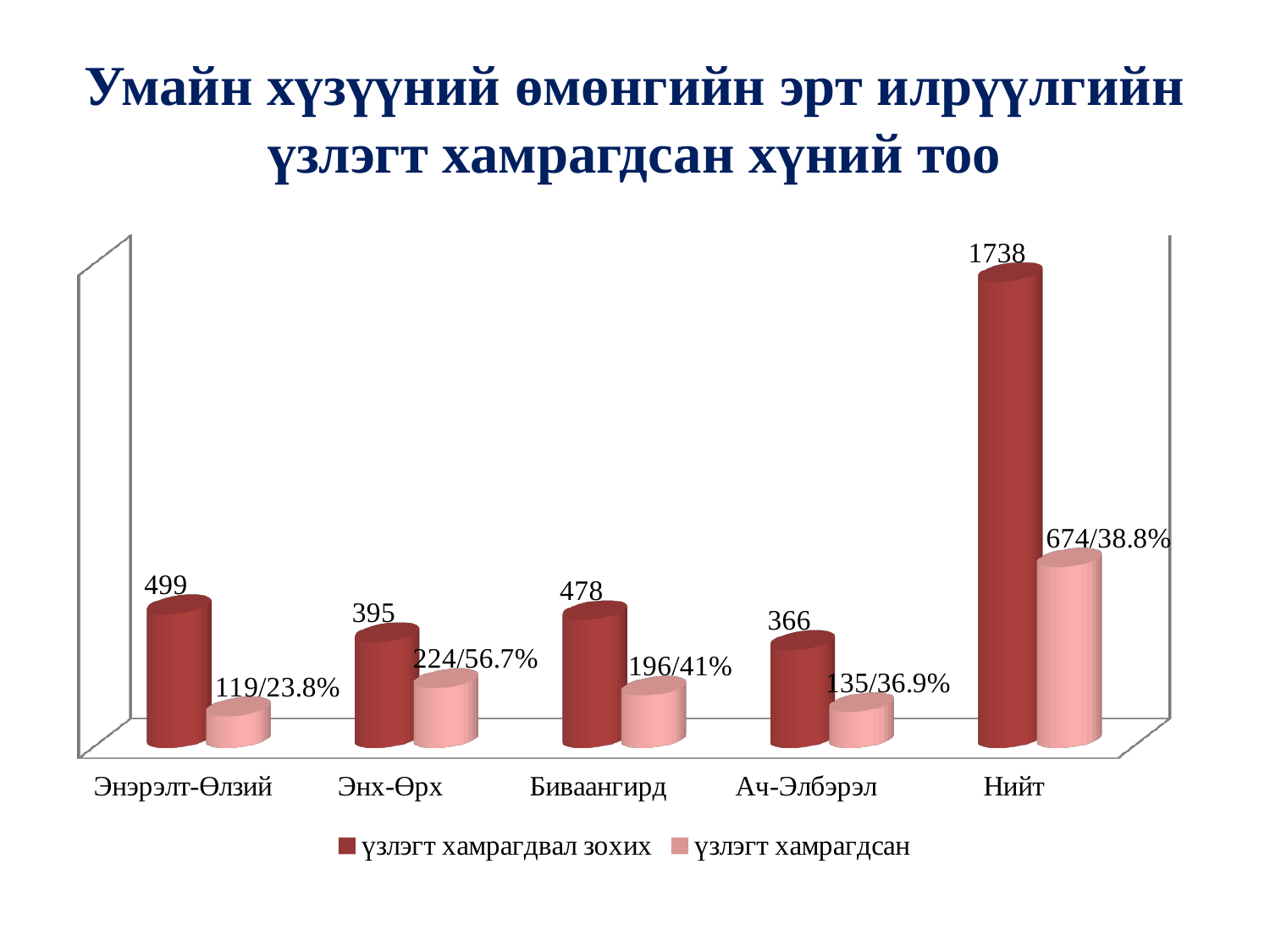
What is the value of "үзлэгт хамрагдвал зохих" for Энэрэлт-Өлзий? 499 What is the difference between the "үзлэгт хамрагдвал зохих" values for Энэрэлт-Өлзий and Энх-Өрх? 104 What data label is shown for "үзлэгт хамрагдсан" for Ач-Элбэрэл? 135/36.9% Which category has the lowest value for "үзлэгт хамрагдвал зохих"? Ач-Элбэрэл What data label is shown for "үзлэгт хамрагдсан" for Энх-Өрх? 224/56.7% Excluding Нийт, which category has the highest value for "үзлэгт хамрагдвал зохих"? Энэрэлт-Өлзий Which series is shown in dark red in the legend? үзлэгт хамрагдвал зохих What is the value of "үзлэгт хамрагдвал зохих" for Нийт? 1738 How many categories are shown on the x axis? 5 Which is larger: the "үзлэгт хамрагдсан" count for Энх-Өрх or for Биваангирд? Энх-Өрх What kind of chart is shown on the slide? Bar chart How many series does the legend list? 2